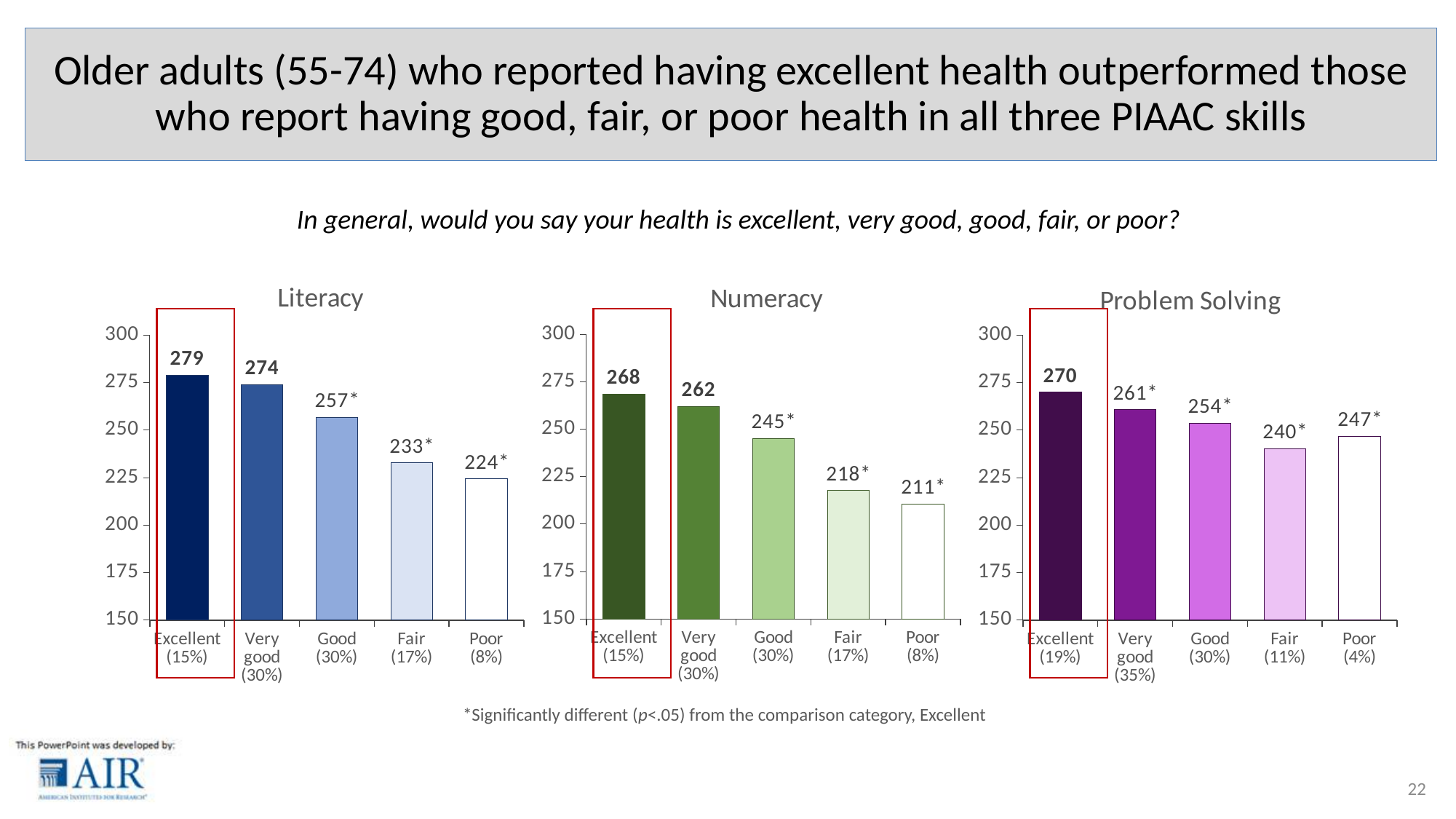
In the Literacy chart, what is the difference between the Excellent and Poor values? 55 In the Numeracy chart, which category has the highest value? Excellent In the Problem Solving chart, which is larger, the value for Fair or the value for Poor? Poor In the Problem Solving chart, what is the value for Poor? 247 In the Literacy chart, which category has the lowest value? Poor In the Numeracy chart, what is the value for Fair? 218 What kind of chart is the Literacy chart? Bar chart In the Literacy chart, what is the value for Excellent? 279 How many categories are shown in the Numeracy chart? 5 In the Numeracy chart, what is the difference between the Very good and Good values? 17 In the Problem Solving chart, which category has the lowest value? Fair In the Numeracy chart, do the values rise or fall from Excellent to Poor? Fall